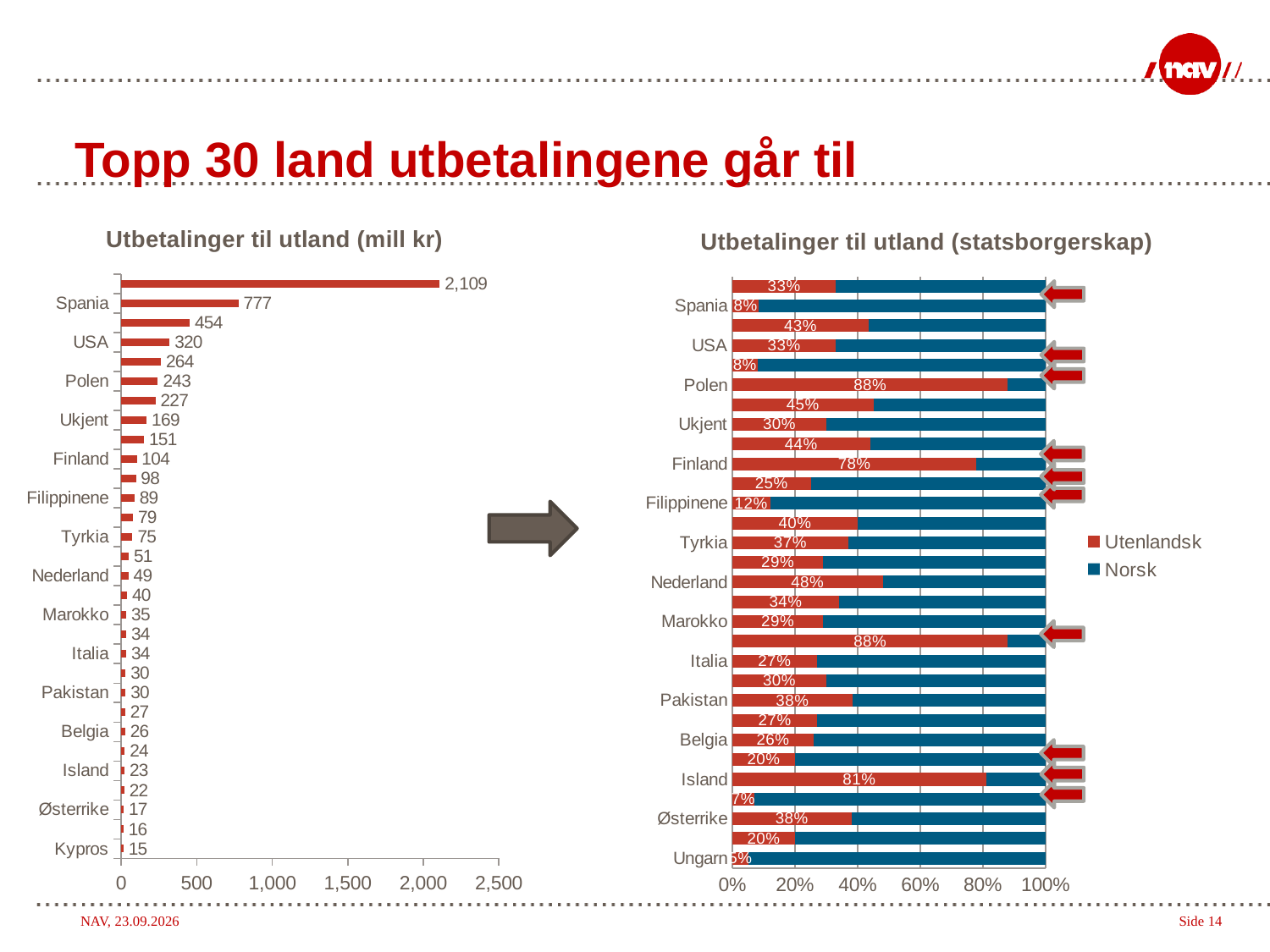
In the chart 'Utbetalinger til utland (mill kr)', what is the value for Kypros? 15 In the chart 'Utbetalinger til utland (mill kr)', what is the value for USA? 320 In the chart 'Utbetalinger til utland (mill kr)', what is the value for Spania? 777 How many series does the legend of the chart 'Utbetalinger til utland (statsborgerskap)' list? 2 How many bars are plotted in the chart 'Utbetalinger til utland (mill kr)'? 30 In the chart 'Utbetalinger til utland (statsborgerskap)', what is the Utenlandsk share for Polen? 88% In the chart 'Utbetalinger til utland (mill kr)', what is the difference between the values for Spania and USA? 457 In the chart 'Utbetalinger til utland (mill kr)', which has the larger value, Polen or Finland? Polen In the chart 'Utbetalinger til utland (statsborgerskap)', what is the Utenlandsk share for Island? 81% In the chart 'Utbetalinger til utland (mill kr)', what is the largest value shown on any bar? 2,109 In the chart 'Utbetalinger til utland (statsborgerskap)', which has the larger Utenlandsk share, Polen or Spania? Polen What kind of chart is 'Utbetalinger til utland (mill kr)'? Bar chart